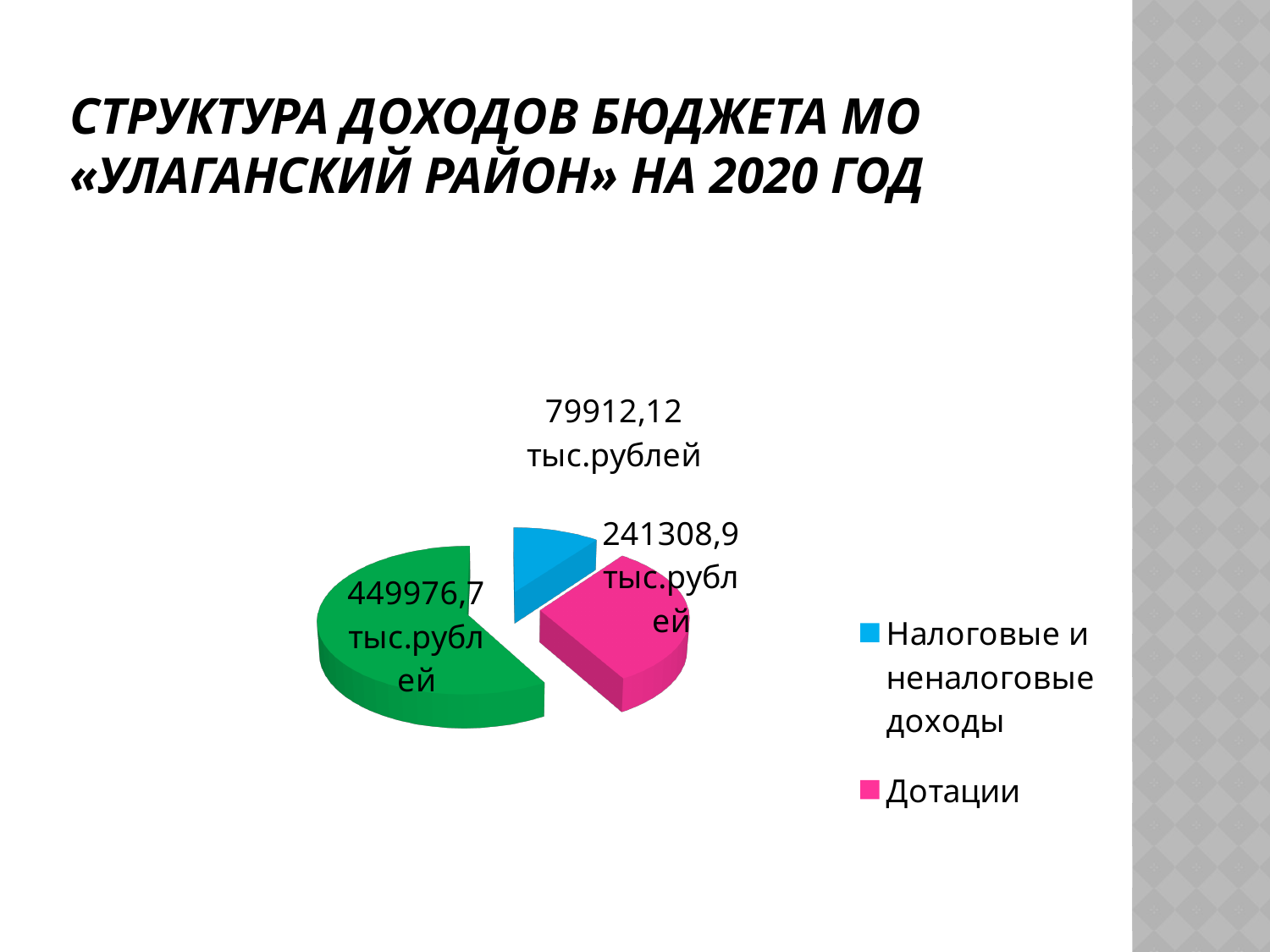
What is the value for Дотации? 241308,9 тыс.рублей What is the title of the slide? Структура доходов бюджета МО «Улаганский район» на 2020 год Which category has the smallest value on the pie chart? Налоговые и неналоговые доходы What is the total of all three values shown on the pie chart? 771197,72 тыс.рублей What is the value for Налоговые и неналоговые доходы? 79912,12 тыс.рублей What colour is the slice for Дотации? Pink Which is larger, Дотации or Налоговые и неналоговые доходы? Дотации How many slices does the pie chart have? 3 What is the difference between the value for Дотации and the value for Налоговые и неналоговые доходы? 161396,78 тыс.рублей What is the largest value shown on the pie chart? 449976,7 тыс.рублей What kind of chart is shown on the slide? Pie chart